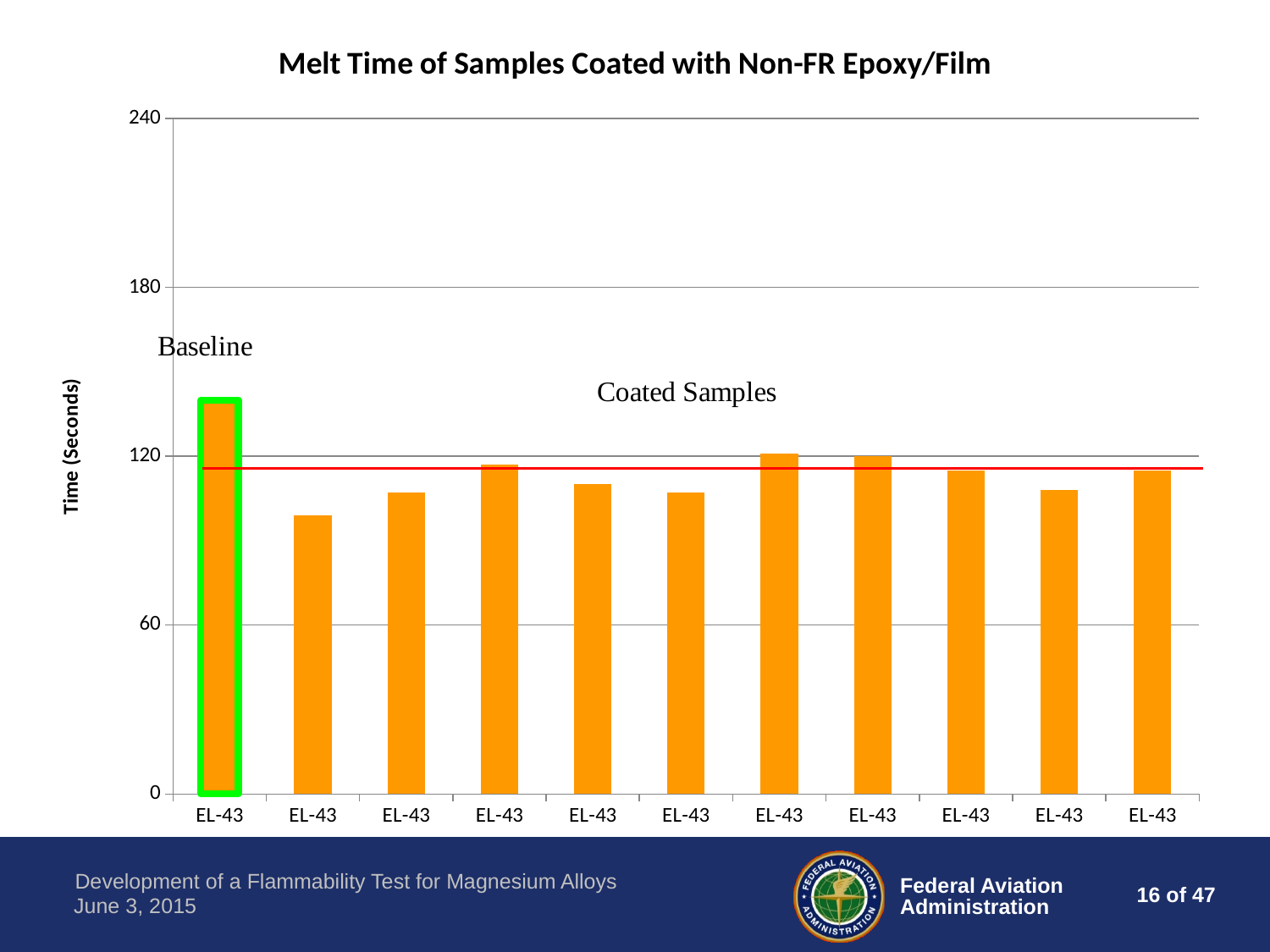
What category label is shown under every bar on the x axis? EL-43 Which bar is the tallest in the chart? the first bar (Baseline) Is the value of the first (Baseline) bar greater or less than 120? greater Is the value of the last bar greater or less than 60? greater Which is larger, the first (Baseline) bar or the second bar? the first (Baseline) bar What is the title of the chart? Melt Time of Samples Coated with Non-FR Epoxy/Film Which bar is the shortest in the chart? the second bar Is the value of the first (Baseline) bar greater or less than 180? less What is the label of the vertical axis? Time (Seconds) How many bars are plotted in the chart? 11 What kind of chart is shown on the slide? bar chart